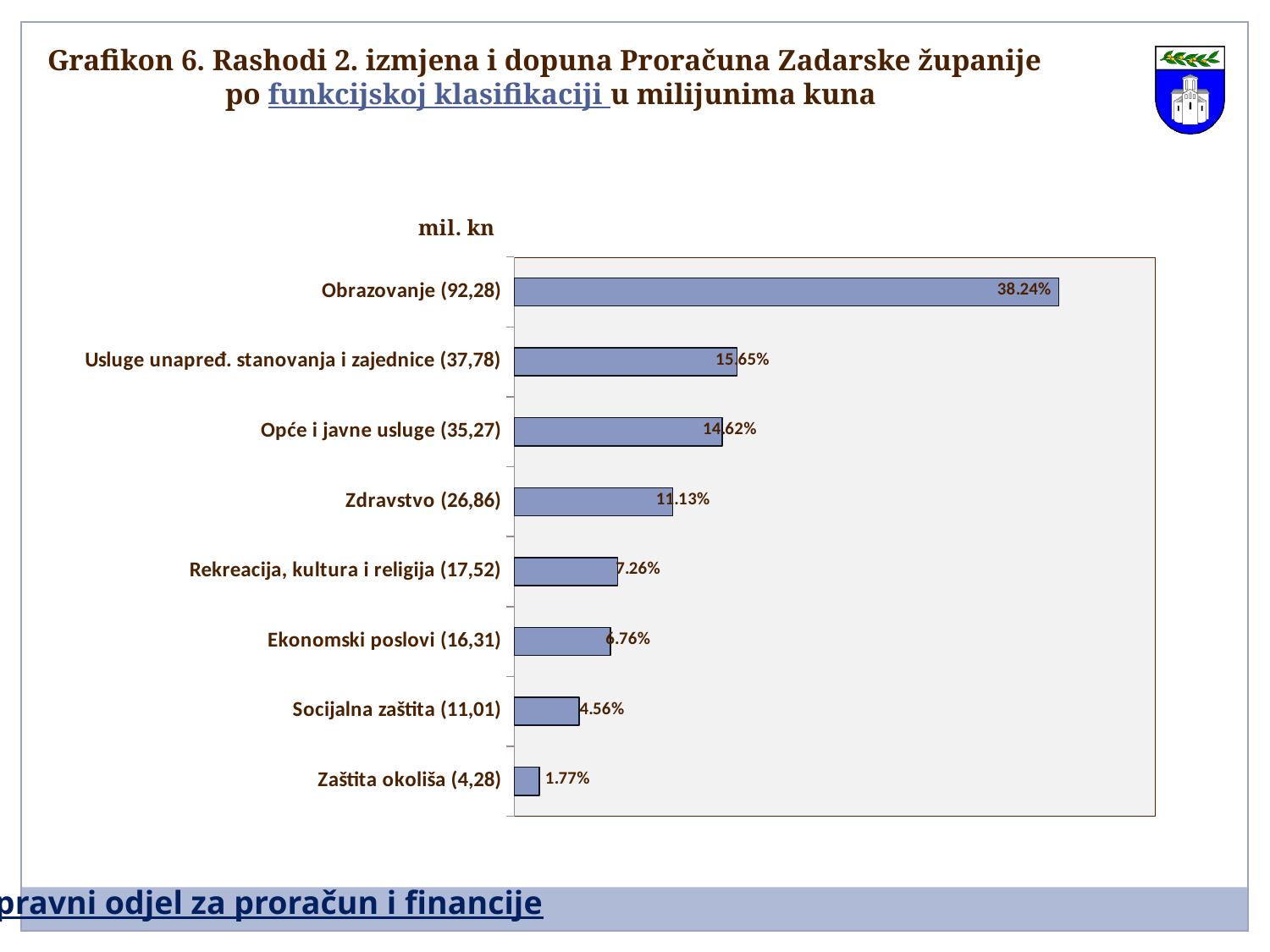
What percentage share is shown for Obrazovanje? 38.24% Which category has the highest share? Obrazovanje What is the difference in percentage points between Obrazovanje (38.24%) and Usluge unapređ. stanovanja i zajednice (15.65%)? 22.59 How many categories are shown in the chart? 8 Which category has the lowest share? Zaštita okoliša What percentage share is shown for Socijalna zaštita? 4.56% What percentage share is shown for Zdravstvo? 11.13% What amount in mil. kn is given in the label for Opće i javne usluge? 35,27 What kind of chart is shown on the slide? Bar chart Which has a larger share, Rekreacija, kultura i religija or Ekonomski poslovi? Rekreacija, kultura i religija What unit label is shown above the category axis of the chart? mil. kn What amount in mil. kn is given in the label for Zaštita okoliša? 4,28